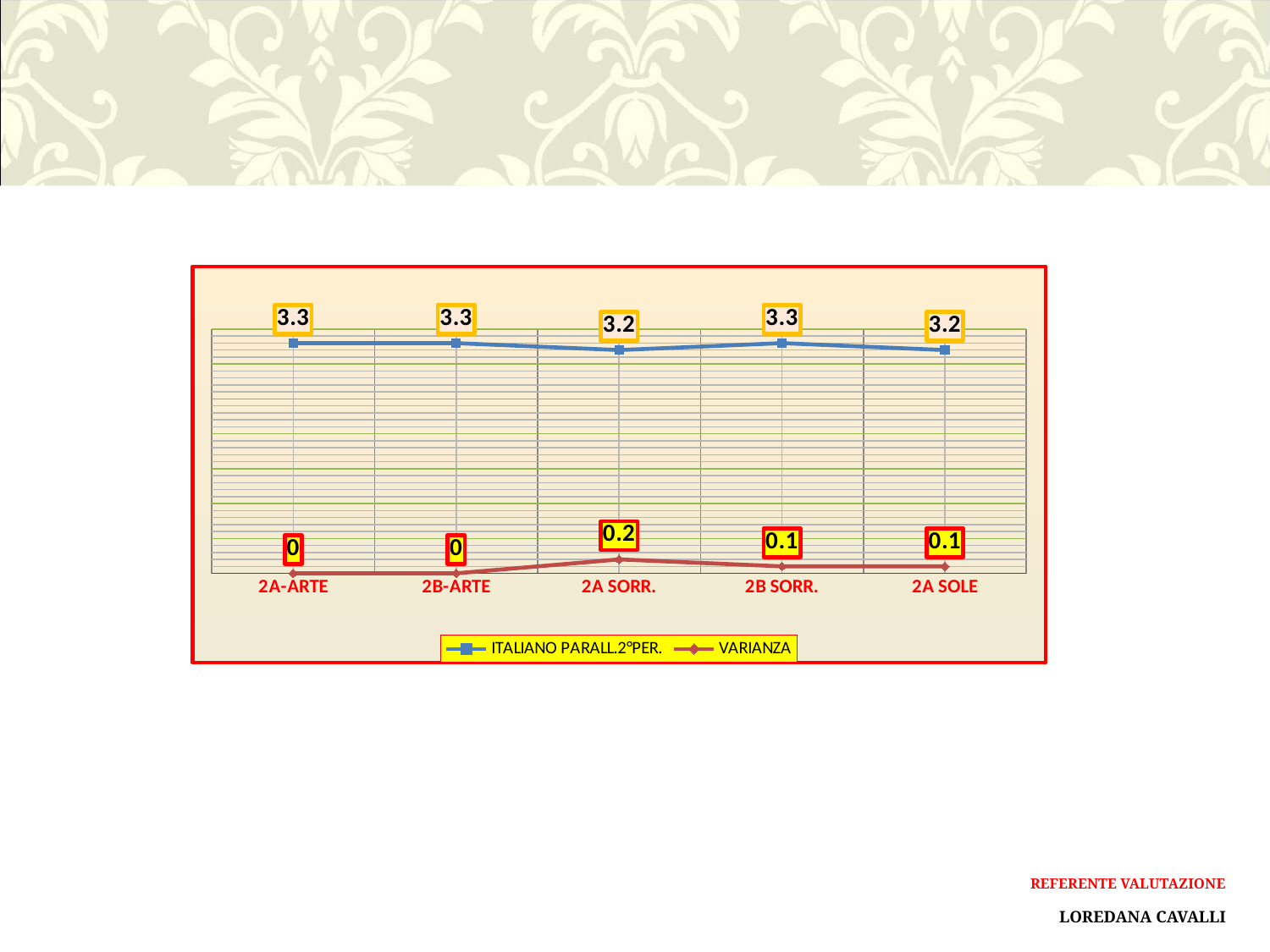
What is the value of ITALIANO PARALL.2°PER. for 2A SORR.? 3.2 How many series does the legend list? 2 What is the VARIANZA value for 2A SORR.? 0.2 How many categories are shown on the x axis? 5 What is the value of ITALIANO PARALL.2°PER. for 2B-ARTE? 3.3 What kind of chart is shown on the slide? Line chart What are the two series named in the legend? ITALIANO PARALL.2°PER. and VARIANZA What is the difference between the VARIANZA values for 2A SORR. and 2A SOLE? 0.1 Which is larger, the ITALIANO PARALL.2°PER. value for 2A-ARTE or for 2A SOLE? 2A-ARTE Which category has the highest VARIANZA value? 2A SORR. What is the VARIANZA value for 2B SORR.? 0.1 What is the difference between the ITALIANO PARALL.2°PER. values for 2B SORR. and 2A SOLE? 0.1